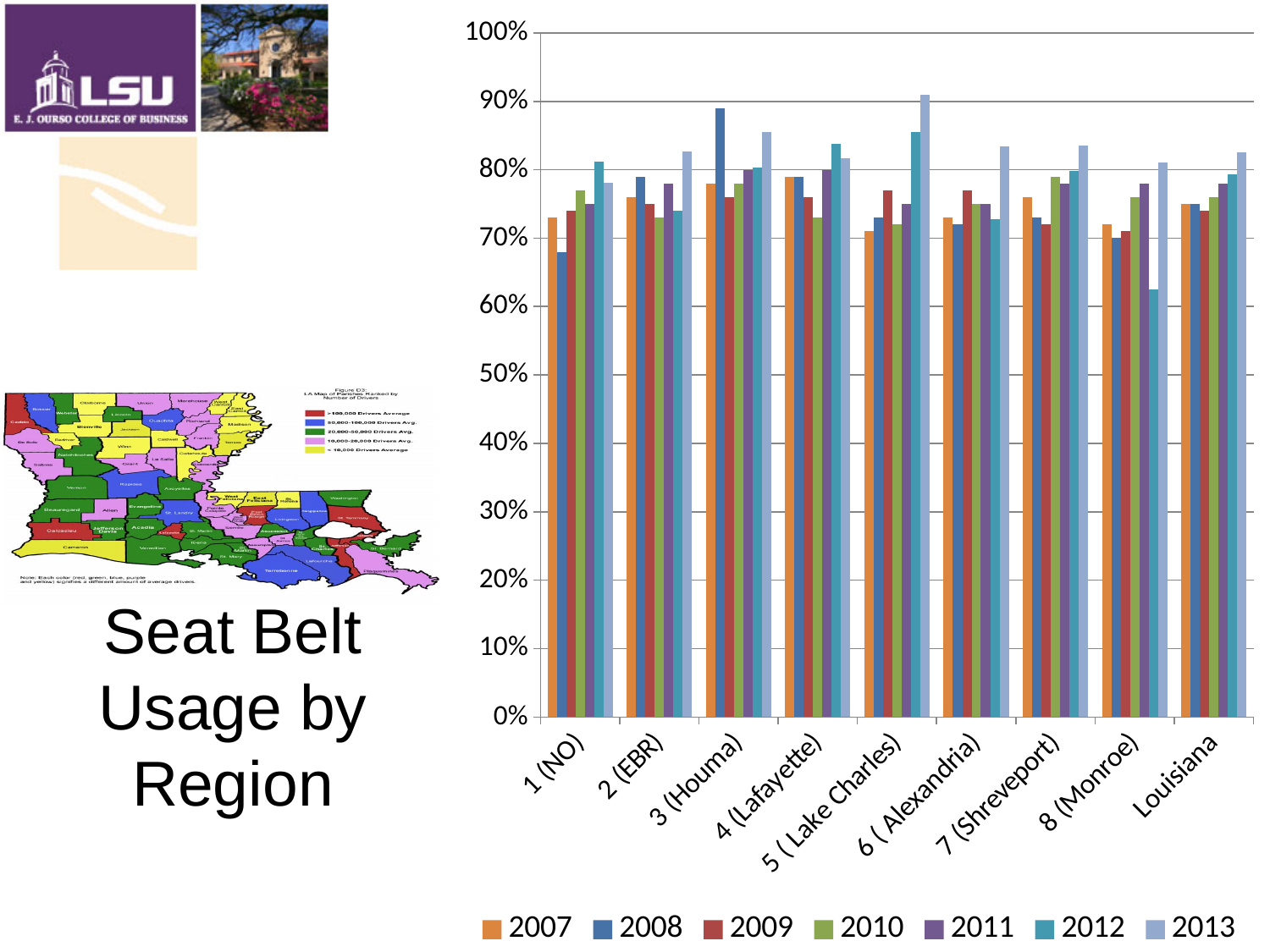
Is the 2008 value for 1 (NO) greater or less than 70%? less For Louisiana, do the values rise or fall from 2011 to 2013? rise For 5 (Lake Charles), which year has the highest seat belt usage? 2013 How many regions (categories) are shown on the x axis? 9 Is the 2008 value for 3 (Houma) greater or less than 80%? greater Which is larger, the 2012 value for 5 (Lake Charles) or the 2012 value for 1 (NO)? 5 (Lake Charles) For 8 (Monroe), which year has the lowest seat belt usage? 2012 Is the 2013 value for 5 (Lake Charles) greater or less than 80%? greater For 1 (NO), which year has the lowest seat belt usage? 2008 What kind of chart is shown on the slide? bar chart How many series does the legend list? 7